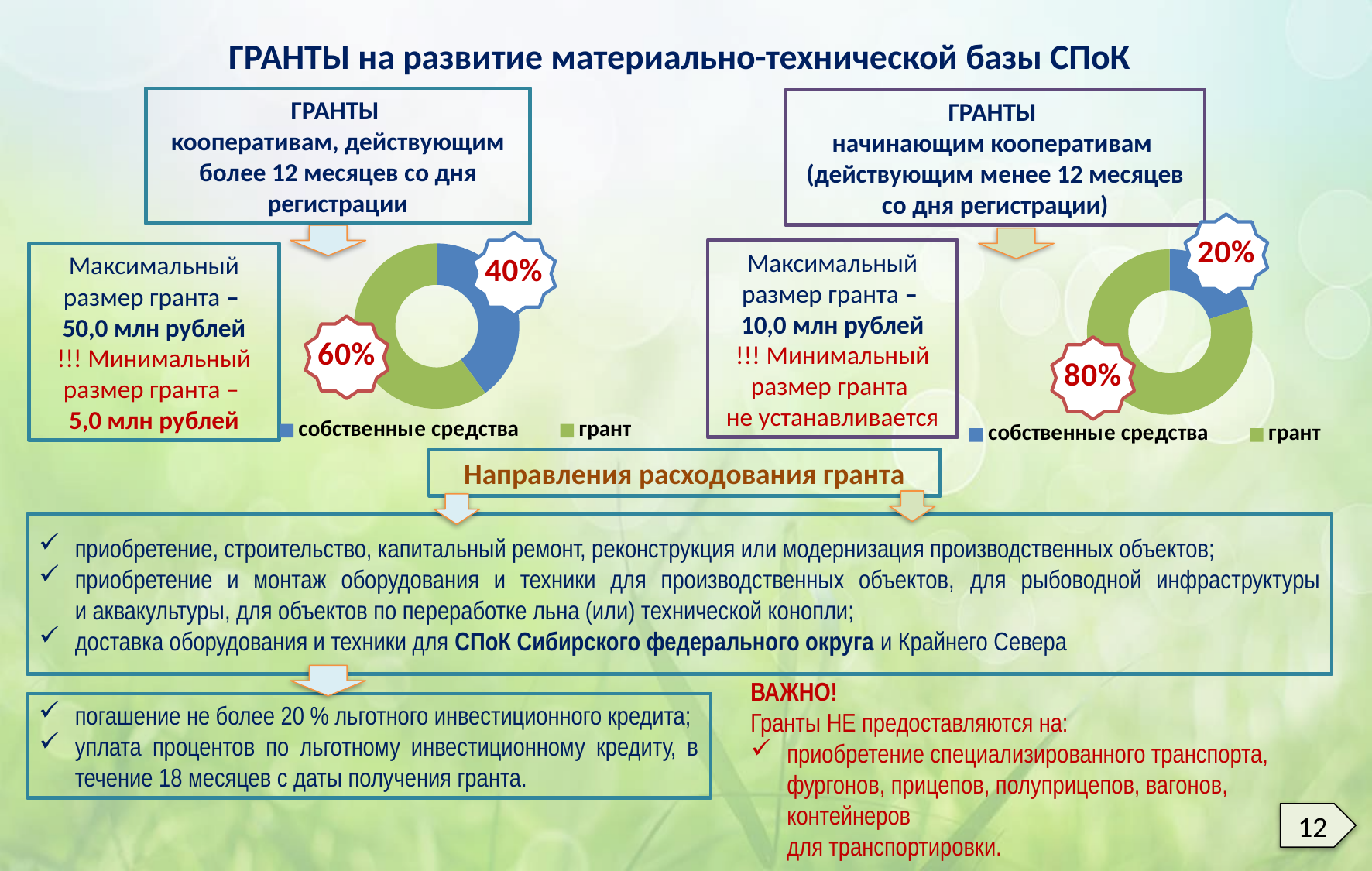
On the left donut chart, which category has the larger share? грант On the right donut chart, what share is labelled for 'собственные средства'? 20% What type of chart is used on the left side of the slide? donut (pie) chart Is the 'грант' share on the right donut chart larger or smaller than the 'грант' share on the left donut chart? larger On the left donut chart, what share is labelled for 'грант'? 60% How many categories does the legend of the left donut chart list? 2 On the right donut chart, which category has the smaller share? собственные средства On the right donut chart, which colour represents 'грант'? green On the right donut chart, what is the difference between the 'грант' share and the 'собственные средства' share? 60% On the right donut chart, what share is labelled for 'грант'? 80% On the left donut chart, what share is labelled for 'собственные средства'? 40% On the left donut chart, what is the difference between the 'грант' share and the 'собственные средства' share? 20%